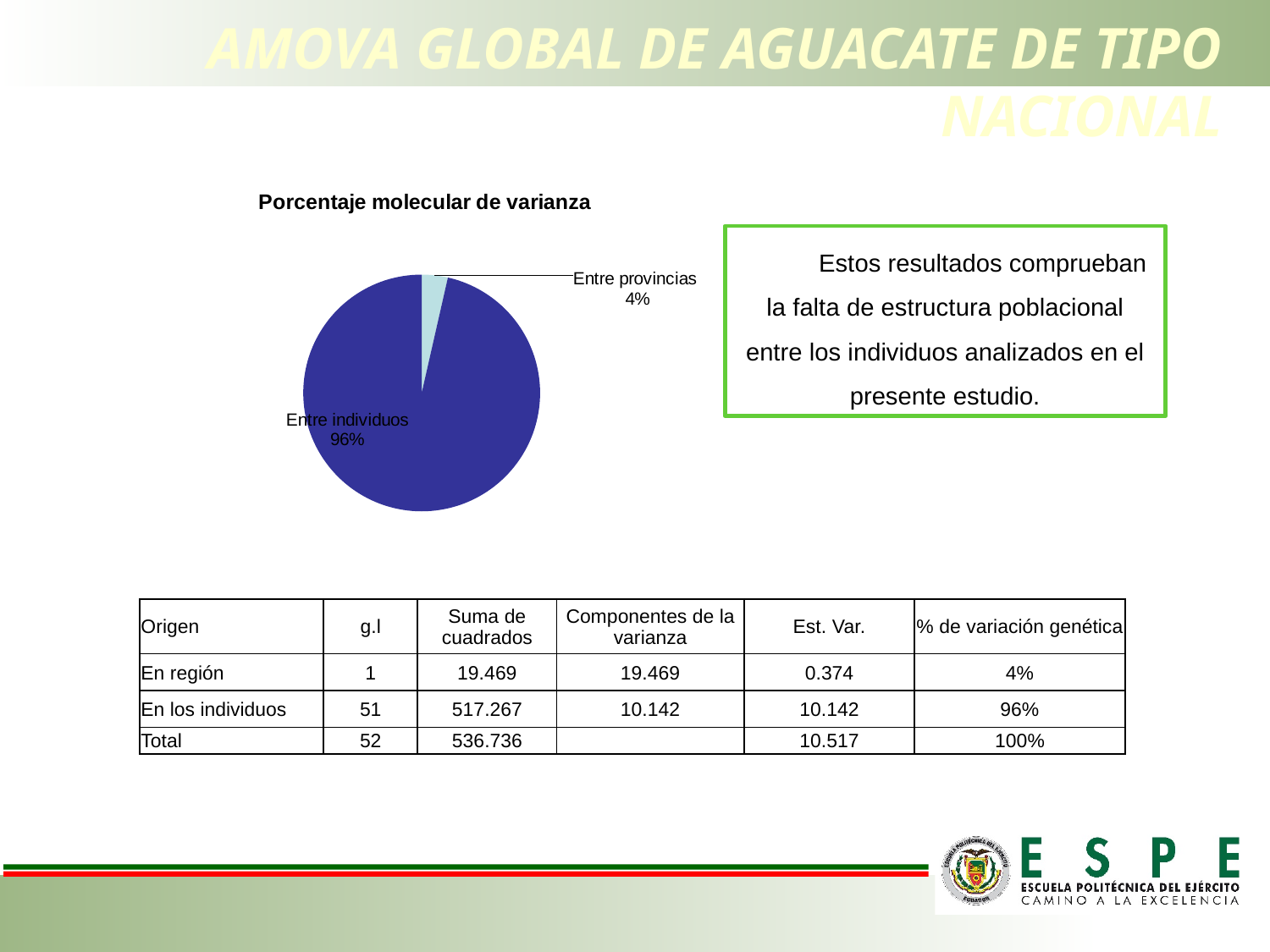
What percentage does the 'Entre individuos' slice represent? 96% Which slice of the pie is the largest? Entre individuos What is the title of the chart? Porcentaje molecular de varianza How many slices does the pie chart have? 2 Which is larger, the 'Entre provincias' slice or the 'Entre individuos' slice? Entre individuos What share of the pie does 'Entre provincias' take? 4% What kind of chart is shown on the slide? pie chart What is the difference in percentage points between the 'Entre individuos' and 'Entre provincias' slices? 92 What colour is the 'Entre individuos' slice? dark blue What percentage does the 'Entre provincias' slice represent? 4% Which slice of the pie is the smallest? Entre provincias